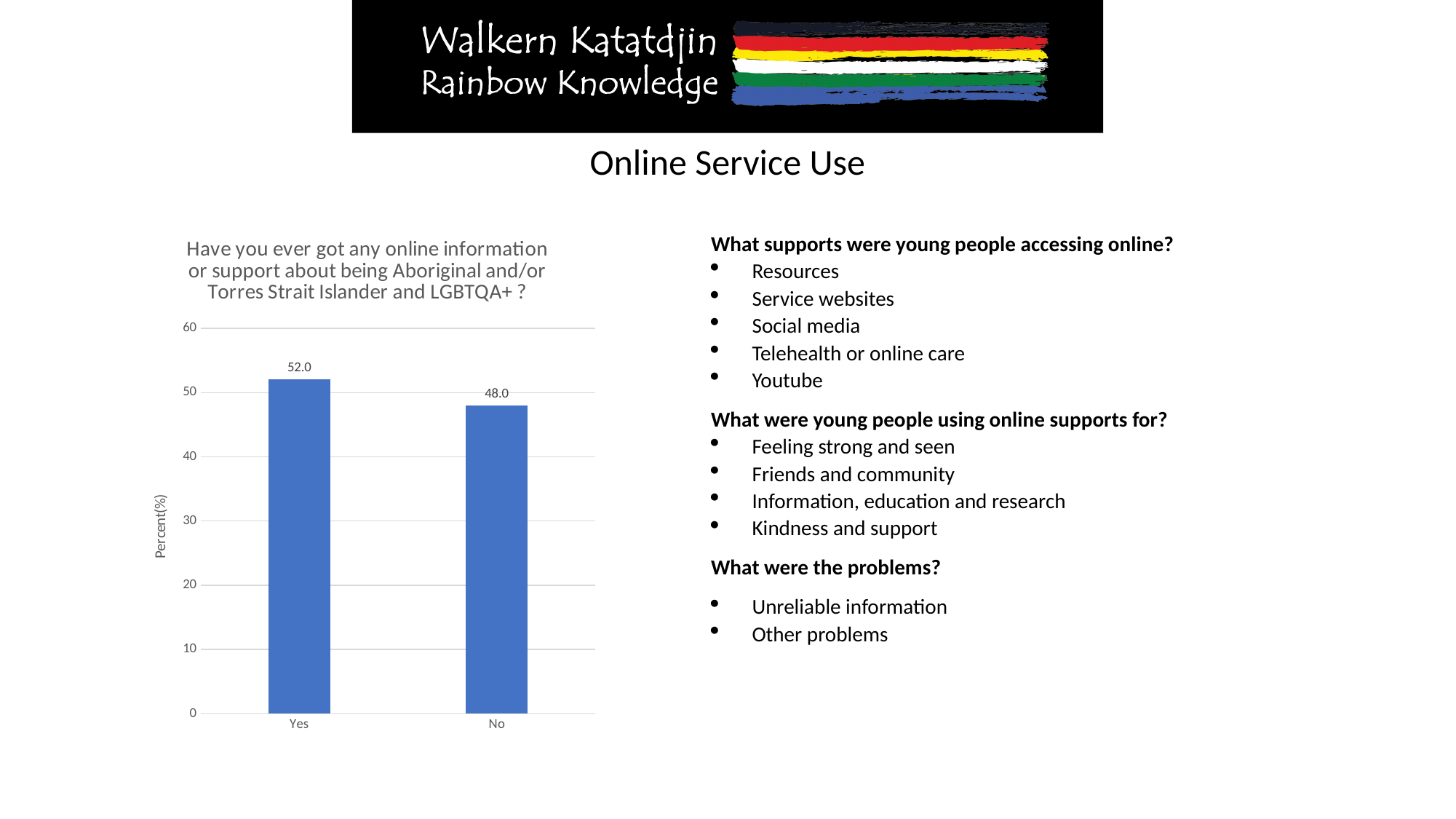
What is the label of the vertical axis? Percent(%) Is the value for No greater or less than 50? less What is the difference between the values for Yes and No? 4.0 Which category has the lowest value? No Is the value for Yes greater or less than 50? greater What kind of chart is shown on the slide? bar chart What is the title of the chart? Have you ever got any online information or support about being Aboriginal and/or Torres Strait Islander and LGBTQA+ ? What is the value for Yes? 52.0 What is the value for No? 48.0 How many categories are shown on the chart? 2 Which is larger, the value for Yes or the value for No? Yes Which category has the highest value? Yes